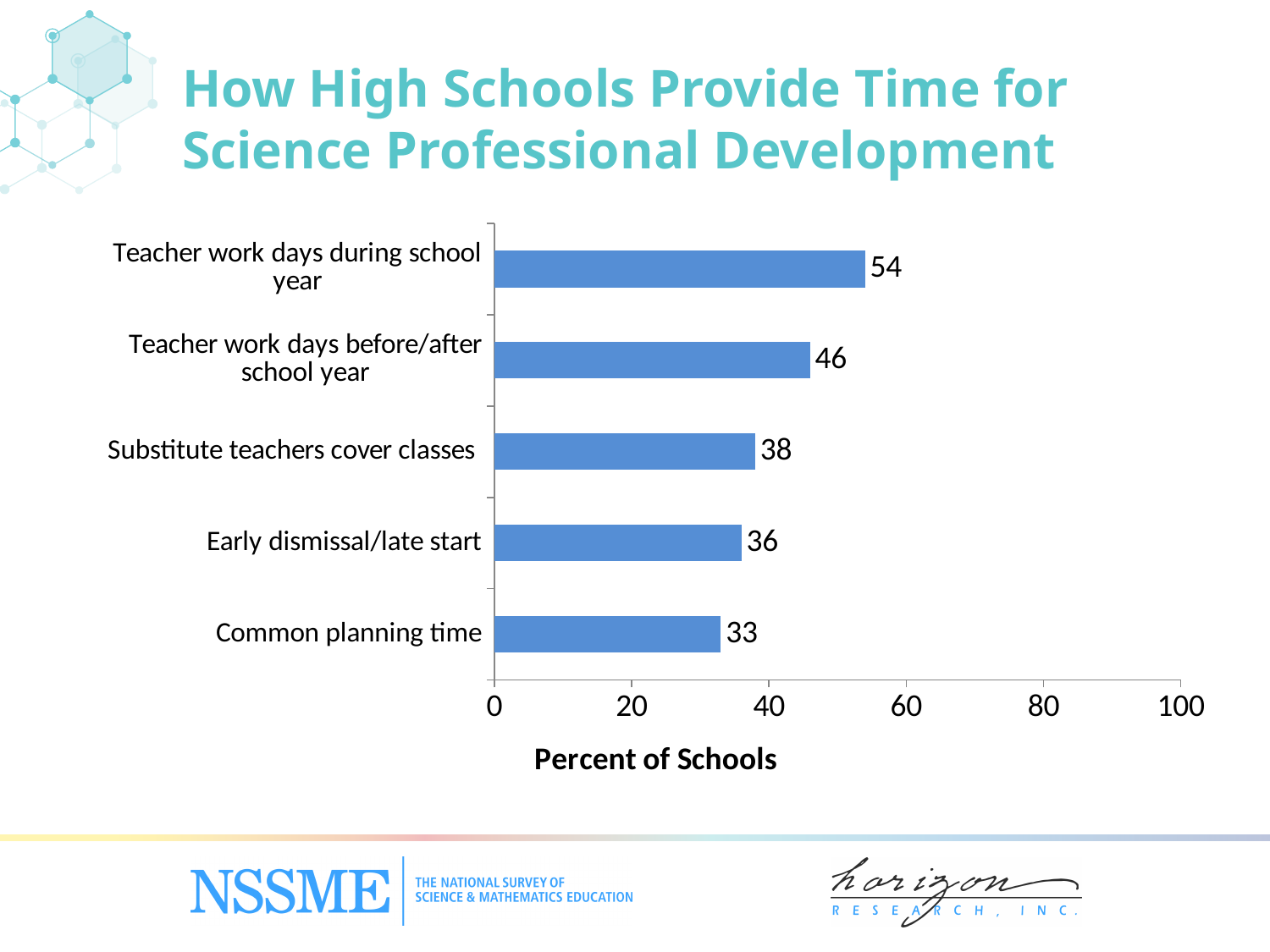
What is the value for 'Early dismissal/late start'? 36 Which category has the highest percent of schools? Teacher work days during school year How many categories are shown in the chart? 5 What is the value for 'Substitute teachers cover classes'? 38 What percent of schools use teacher work days during the school year to provide time for science professional development? 54 What kind of chart is shown on the slide? Bar chart Is the value for 'Teacher work days during school year' greater or less than 60? less What is the value for 'Common planning time'? 33 Which category has the lowest percent of schools? Common planning time Which is larger: 'Teacher work days before/after school year' or 'Early dismissal/late start'? Teacher work days before/after school year What is the difference between 'Teacher work days during school year' and 'Teacher work days before/after school year'? 8 What is the difference between 'Substitute teachers cover classes' and 'Common planning time'? 5